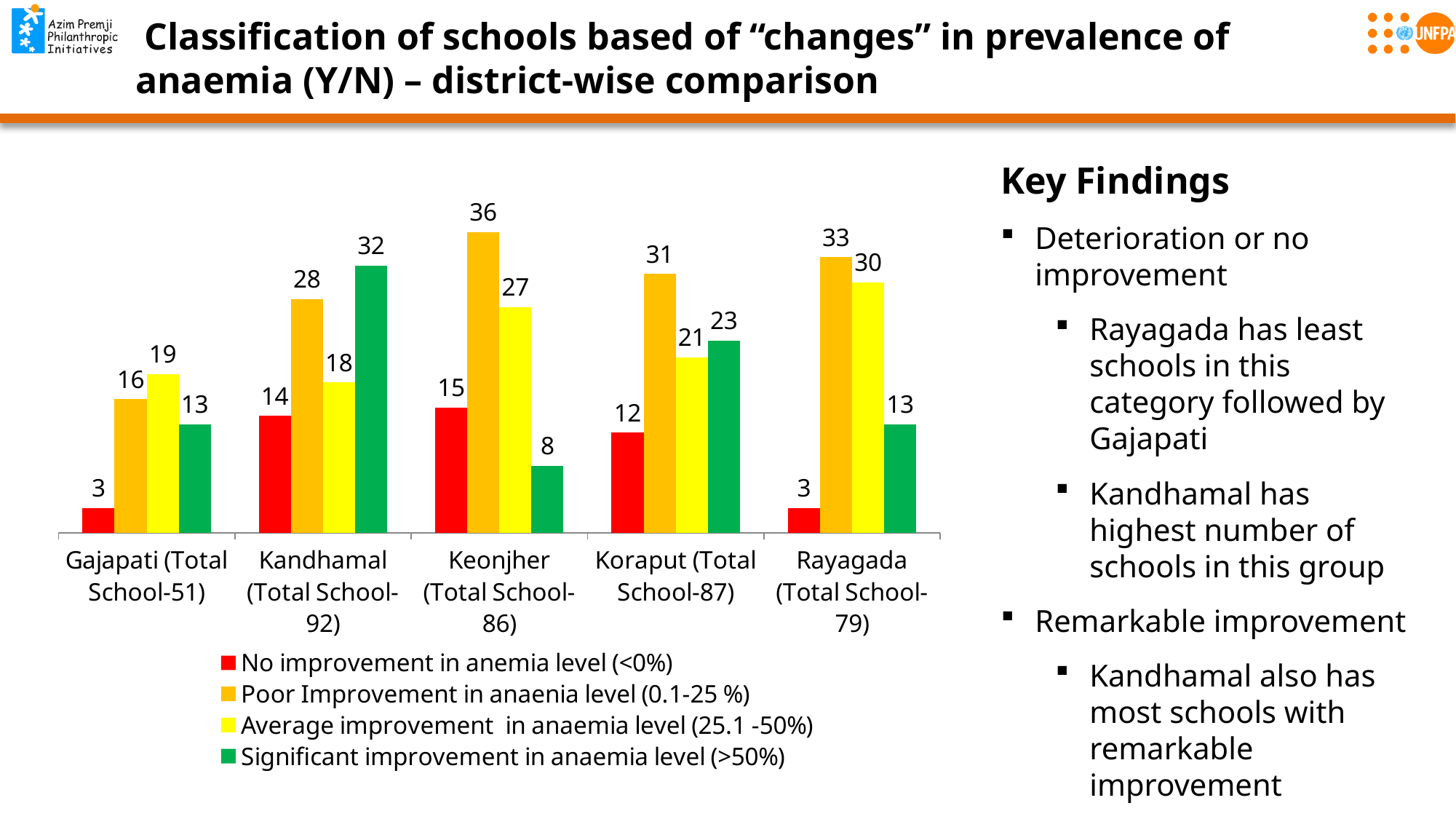
What is the value for 'Average improvement in anaemia level (25.1 -50%)' for Koraput? 21 What is the value for 'No improvement in anemia level (<0%)' for Rayagada? 3 What is the difference between the 'Significant improvement' values for Kandhamal and Keonjher? 24 What colour represents 'No improvement in anemia level (<0%)' in the legend? Red Which is larger: the 'Average improvement' value for Rayagada or for Keonjher? Rayagada How many districts are shown on the x axis? 5 What is the value for 'Significant improvement in anaemia level (>50%)' for Kandhamal? 32 Which district has the lowest value for 'Significant improvement in anaemia level (>50%)'? Keonjher What is the value for 'Poor Improvement in anaenia level (0.1-25 %)' for Keonjher? 36 How many series does the legend list? 4 Which district has the highest value for 'Poor Improvement in anaenia level (0.1-25 %)'? Keonjher What kind of chart is shown on the slide? Bar chart